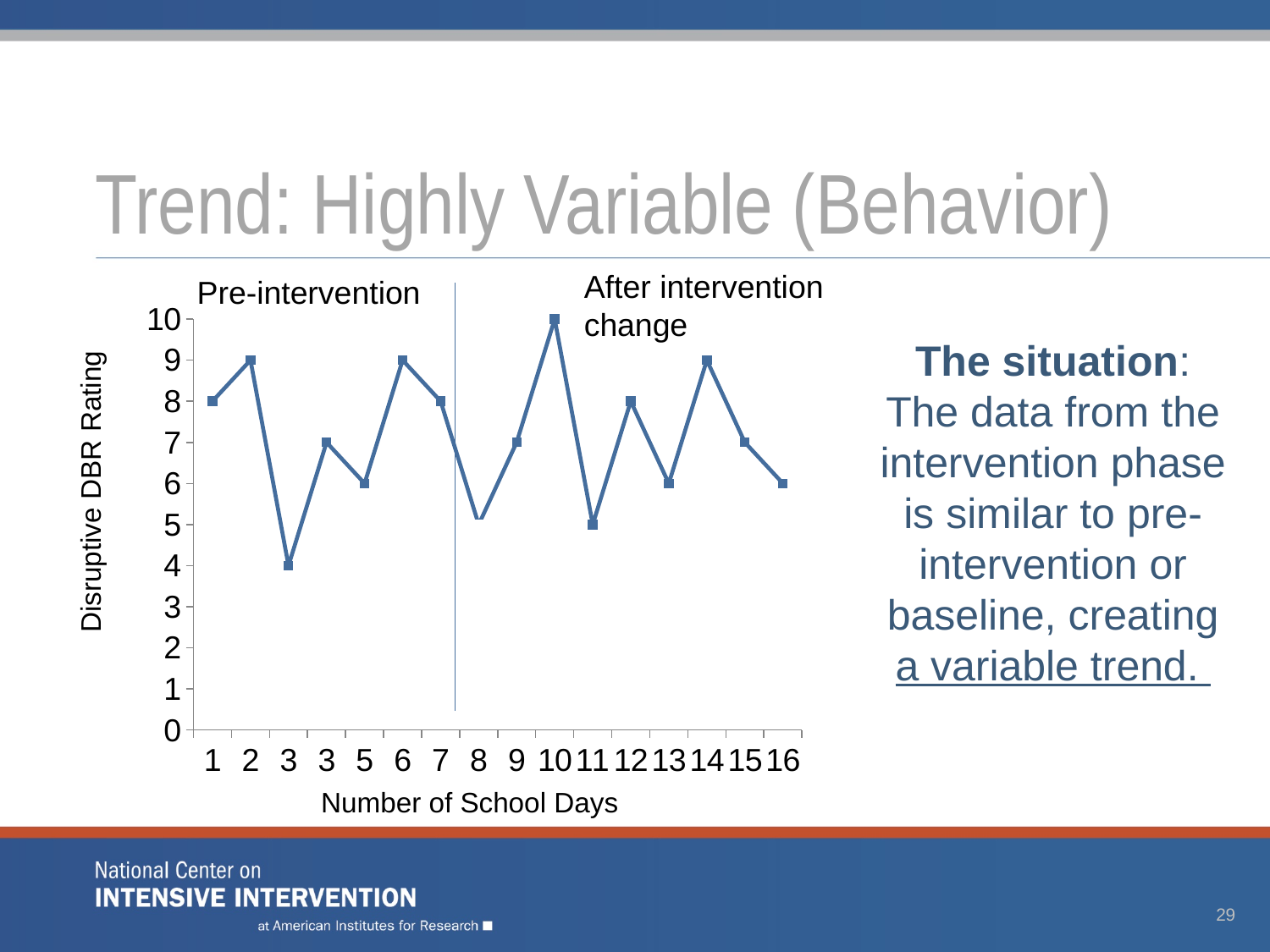
How many school days are plotted on the x axis? 16 Is the Disruptive DBR Rating on school day 8 greater or less than 6? less What label appears to the right of the vertical divider line on the chart? After intervention change What is the Disruptive DBR Rating on school day 11? 5 What is the Disruptive DBR Rating on school day 14? 9 What is the Disruptive DBR Rating on school day 1? 8 What is the Disruptive DBR Rating on school day 10? 10 What is the difference between the Disruptive DBR Rating on day 10 and on day 11? 5 What type of chart is shown on the slide? line chart What is the lowest Disruptive DBR Rating plotted on the chart? 4 Which has a higher Disruptive DBR Rating, school day 2 or school day 5? school day 2 On which school day is the Disruptive DBR Rating highest? 10